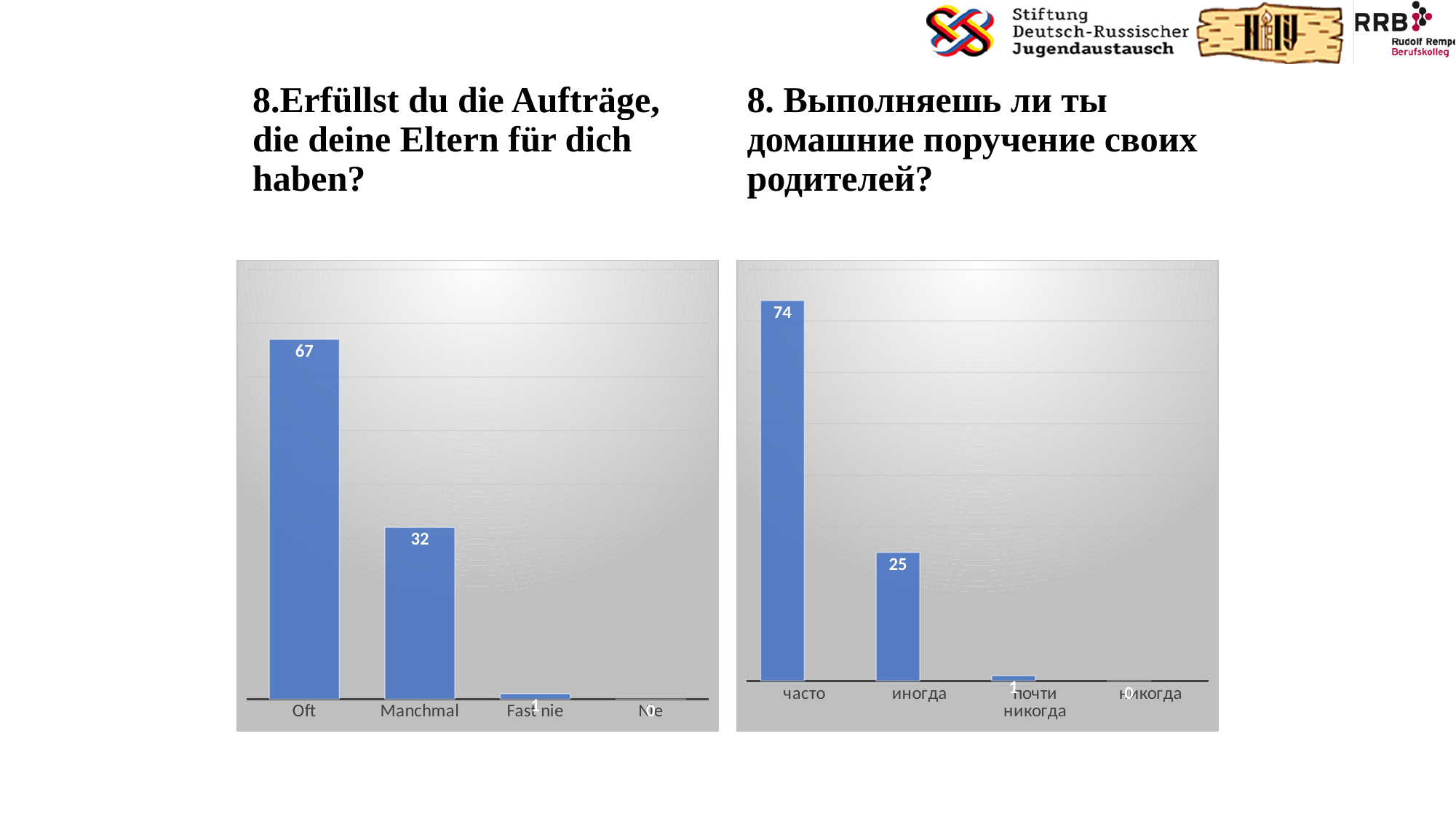
In the right chart, which category has the lowest value? никогда In the right chart, what is the value for часто? 74 How many categories does the left chart show? 4 In the left chart, what is the difference between the values for Oft and Manchmal? 35 In the left chart, what is the value for Oft? 67 In the right chart, what is the difference between the values for часто and иногда? 49 In the left chart, what is the value for Manchmal? 32 What kind of chart is the right chart? bar chart In the left chart, which category has the highest value? Oft In the right chart, what is the value for иногда? 25 In the left chart, do the values rise or fall from left to right along the x axis? fall In the right chart, which is larger, the value for иногда or the value for почти никогда? иногда